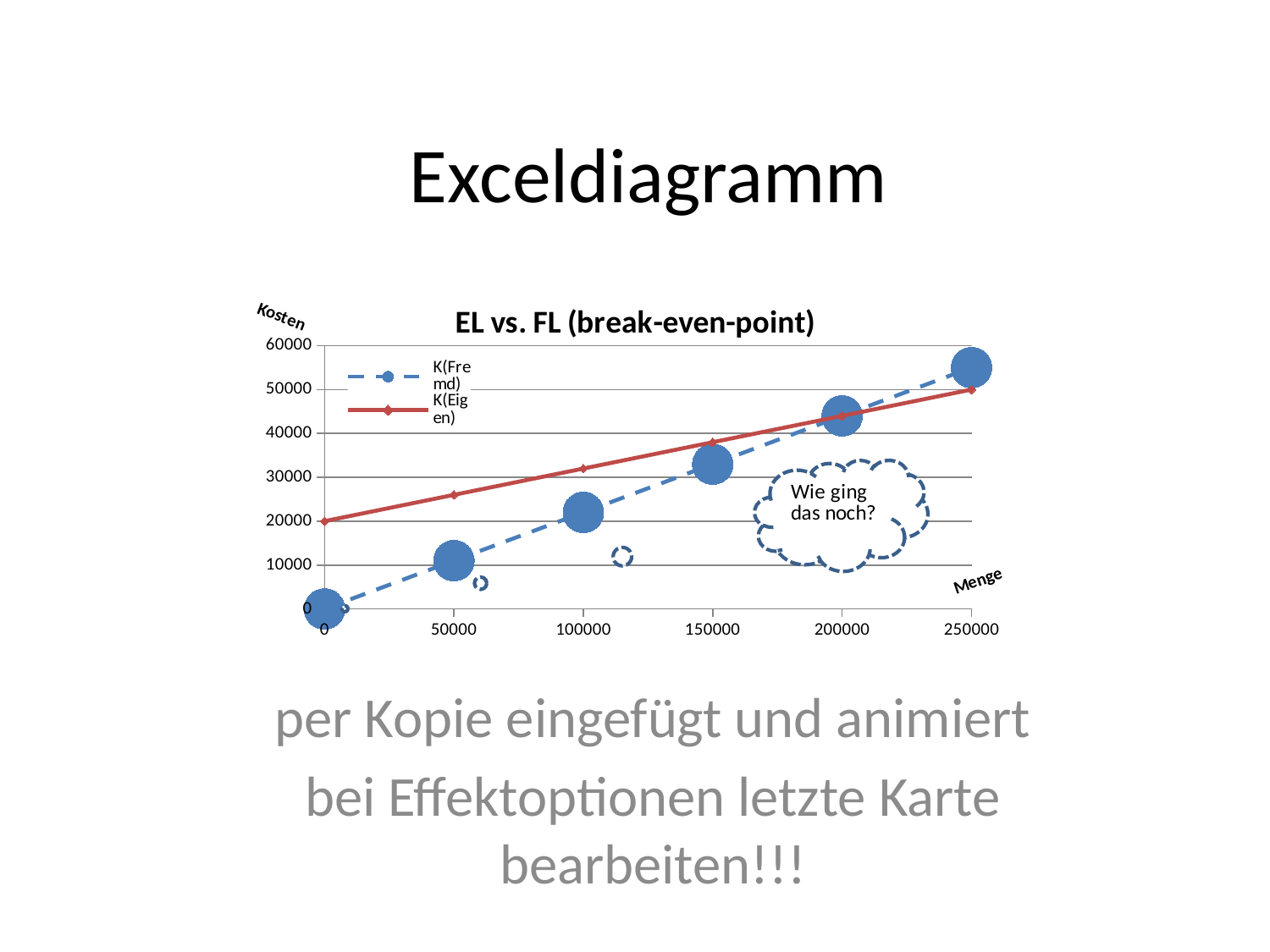
What kind of chart is shown on the slide? line chart What is the value of K(Eigen) at a Menge of 250000? 50000 Is the value of K(Fremd) at a Menge of 250000 greater or less than 50000? greater Is the value of K(Eigen) at a Menge of 150000 greater or less than 30000? greater How many series does the chart legend list? 2 Do the values of K(Fremd) rise or fall as Menge increases along the x axis? rise What is the value of K(Eigen) at a Menge of 0? 20000 What is the title of the chart? EL vs. FL (break-even-point) Is the value of K(Fremd) at a Menge of 100000 greater or less than 30000? less What is the value of K(Fremd) at a Menge of 0? 0 At a Menge of 100000, which series has the higher value, K(Fremd) or K(Eigen)? K(Eigen) Which two series are listed in the chart legend? K(Fremd) and K(Eigen)